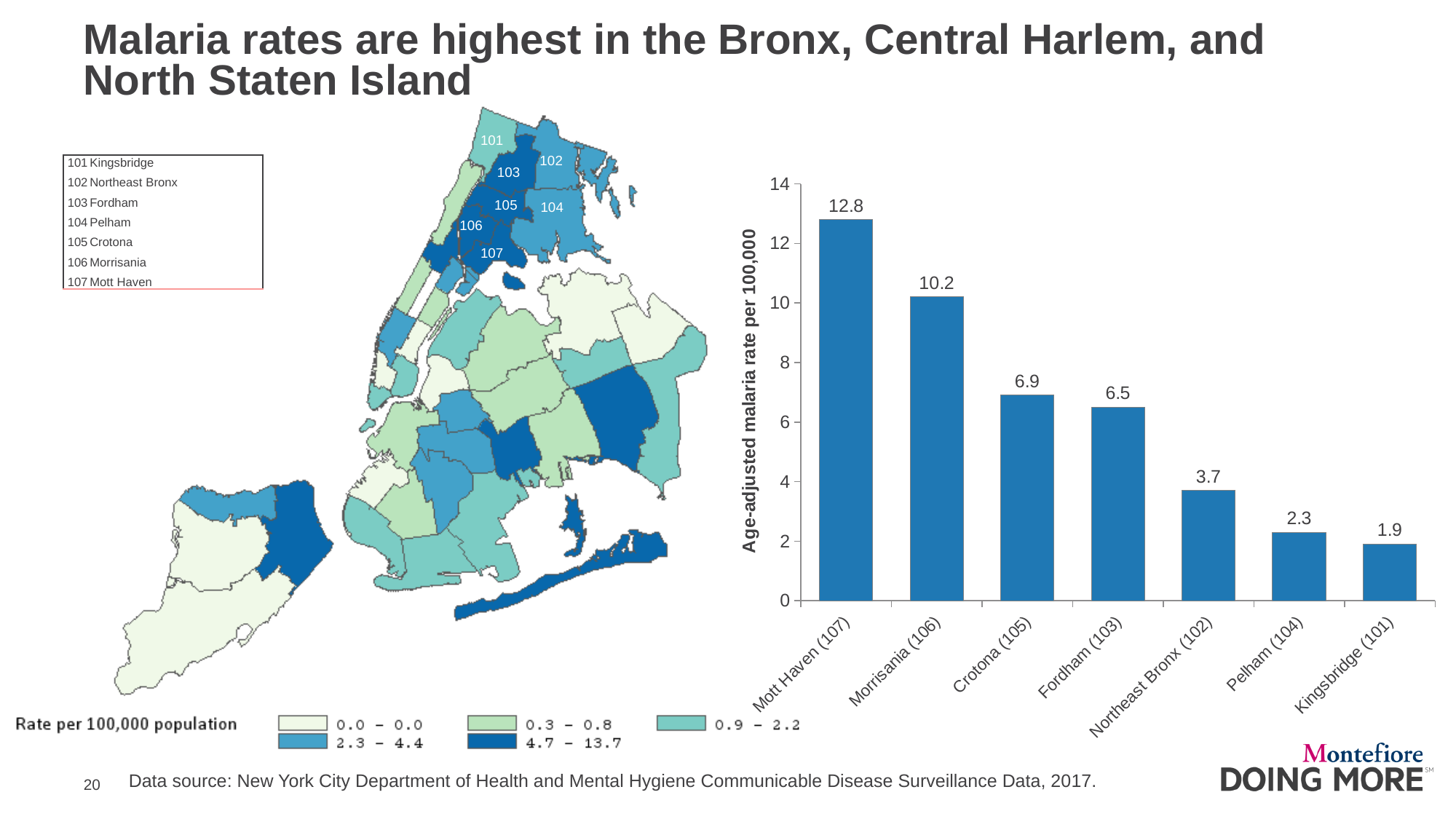
In the bar chart, what is the age-adjusted malaria rate per 100,000 for Fordham (103)? 6.5 In the bar chart, which neighborhood has the highest age-adjusted malaria rate? Mott Haven (107) What kind of chart is shown on the right side of the slide? Bar chart In the bar chart, do the values rise or fall from left to right along the x axis? Fall In the bar chart, which neighborhood has the lowest age-adjusted malaria rate? Kingsbridge (101) In the bar chart, is the value for Northeast Bronx (102) greater or less than 4? less How many neighborhoods are shown in the bar chart? 7 In the bar chart, which has a higher malaria rate, Morrisania (106) or Crotona (105)? Morrisania (106) In the bar chart, what is the age-adjusted malaria rate per 100,000 for Mott Haven (107)? 12.8 In the bar chart, what is the age-adjusted malaria rate per 100,000 for Pelham (104)? 2.3 In the bar chart, what is the difference between the malaria rates for Mott Haven (107) and Morrisania (106)? 2.6 In the bar chart, what is the difference between the malaria rates for Crotona (105) and Northeast Bronx (102)? 3.2